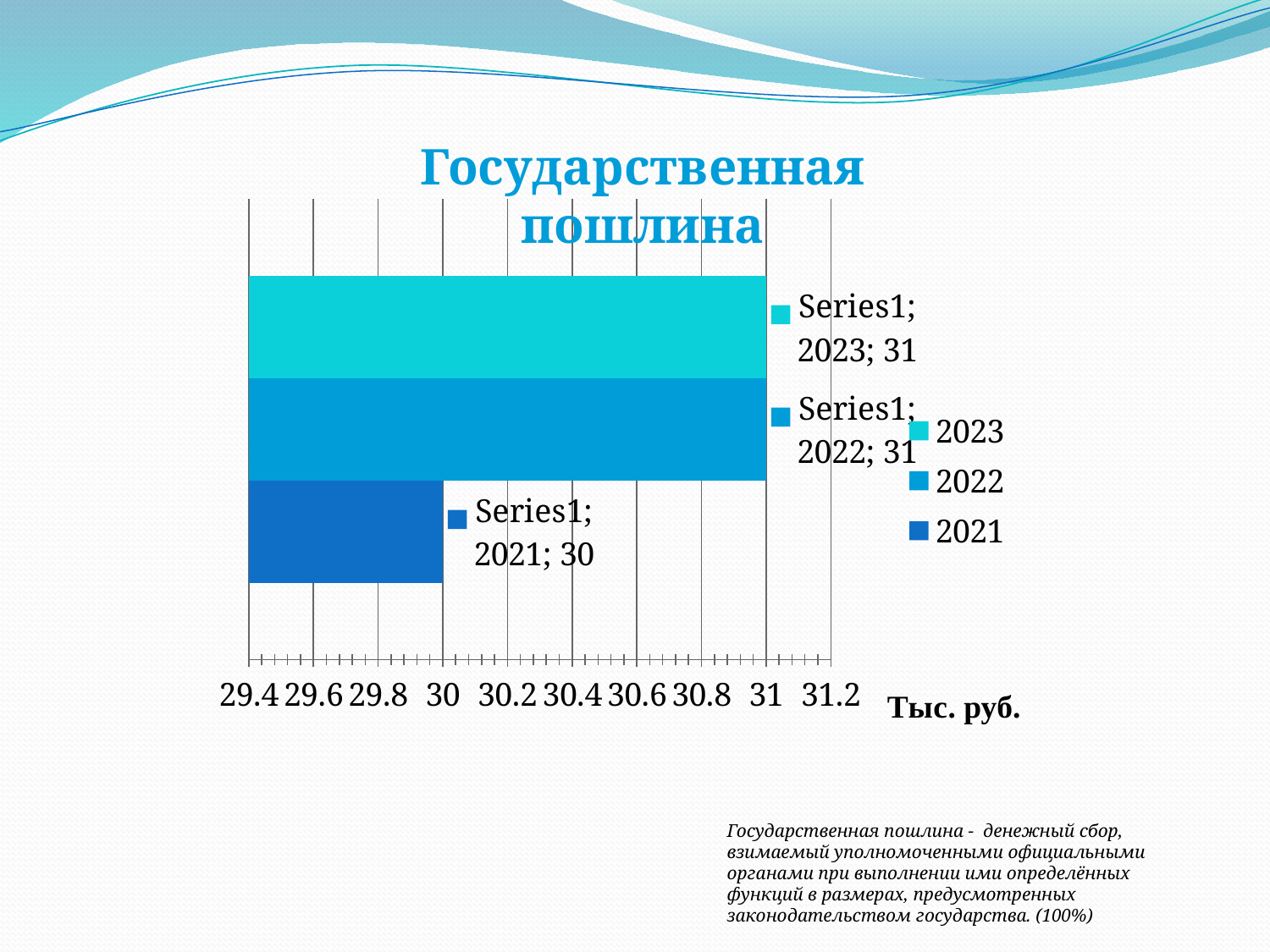
What is the value for 2021 in the chart? 30 What type of chart is shown on the slide? Bar chart Does the value increase or decrease from 2021 to 2022? Increase What is the title of the chart? Государственная пошлина How many entries does the chart legend list? 3 Which is larger, the value for 2022 or the value for 2021? 2022 Is the value for 2023 greater or less than 30.5? greater What is the difference between the values for 2023 and 2021? 1 How many bars are shown in the chart? 3 What is the value for 2022 in the chart? 31 Which year has the lowest value in the chart? 2021 What is the value for 2023 in the chart? 31